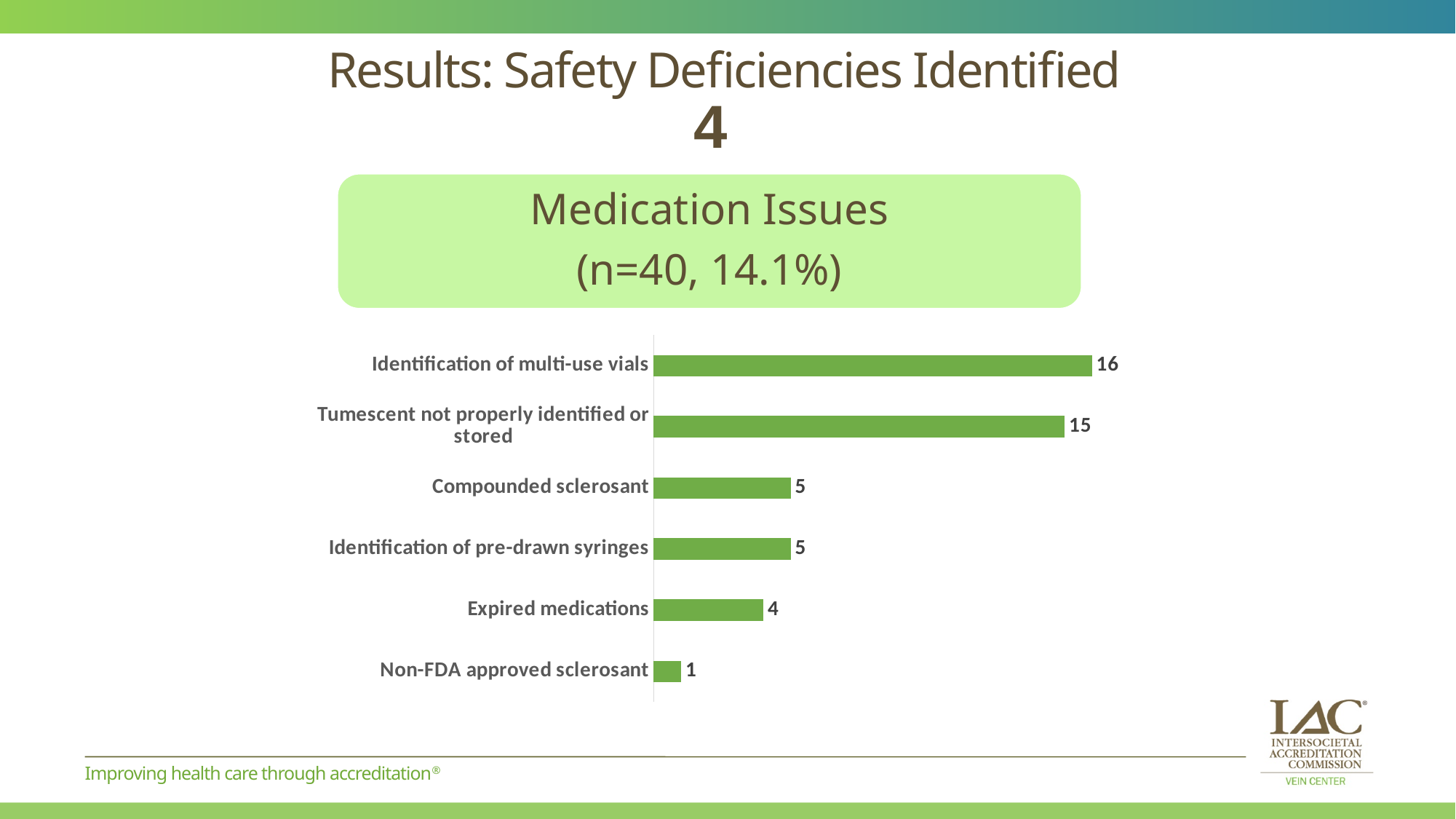
What is the value for Identification of multi-use vials? 16 Which is larger, the value for Expired medications or the value for Identification of pre-drawn syringes? Identification of pre-drawn syringes What kind of chart is shown on the slide? Bar chart Which category has the lowest value? Non-FDA approved sclerosant What is the value for Non-FDA approved sclerosant? 1 What is the value for Expired medications? 4 What is the total of all the values shown in the chart? 46 What is the difference between the values for Identification of multi-use vials and Compounded sclerosant? 11 What is the heading shown in the green box above the chart? Medication Issues (n=40, 14.1%) How many categories are shown in the chart? 6 Which category has the highest value? Identification of multi-use vials What is the value for Tumescent not properly identified or stored? 15